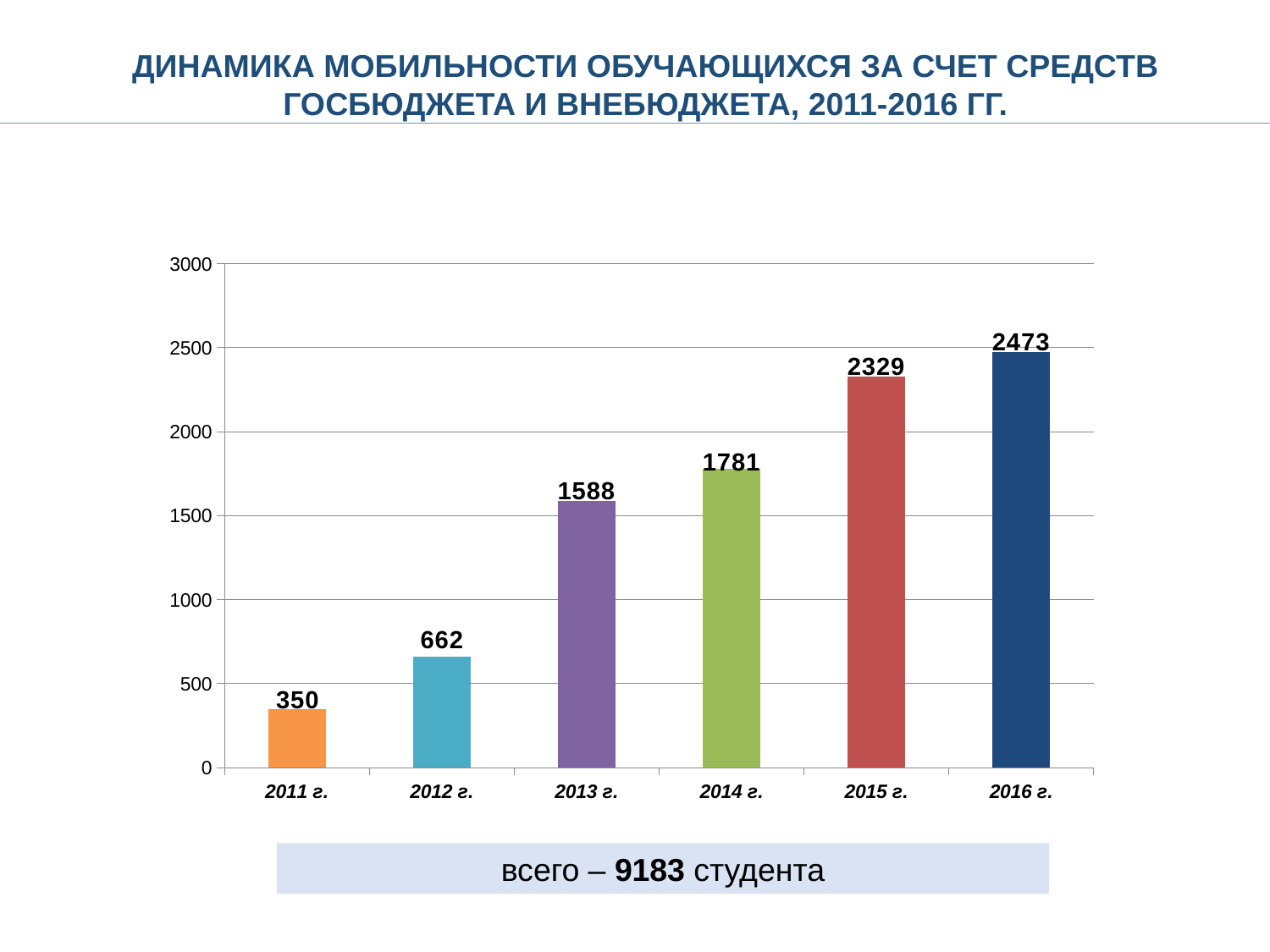
What is the difference between the values for 2016 г. and 2015 г.? 144 How many years are shown on the x axis? 6 Is the value for 2014 г. greater or less than 2000? less What kind of chart is shown on the slide? bar chart What is the difference between the values for 2012 г. and 2011 г.? 312 Which year has the lowest value? 2011 г. Which year has the highest value? 2016 г. What is the value for 2013 г.? 1588 What is the value for 2015 г.? 2329 Which is larger, the value for 2014 г. or the value for 2013 г.? 2014 г. Do the values rise or fall from 2011 г. to 2016 г.? rise What is the value for 2011 г.? 350